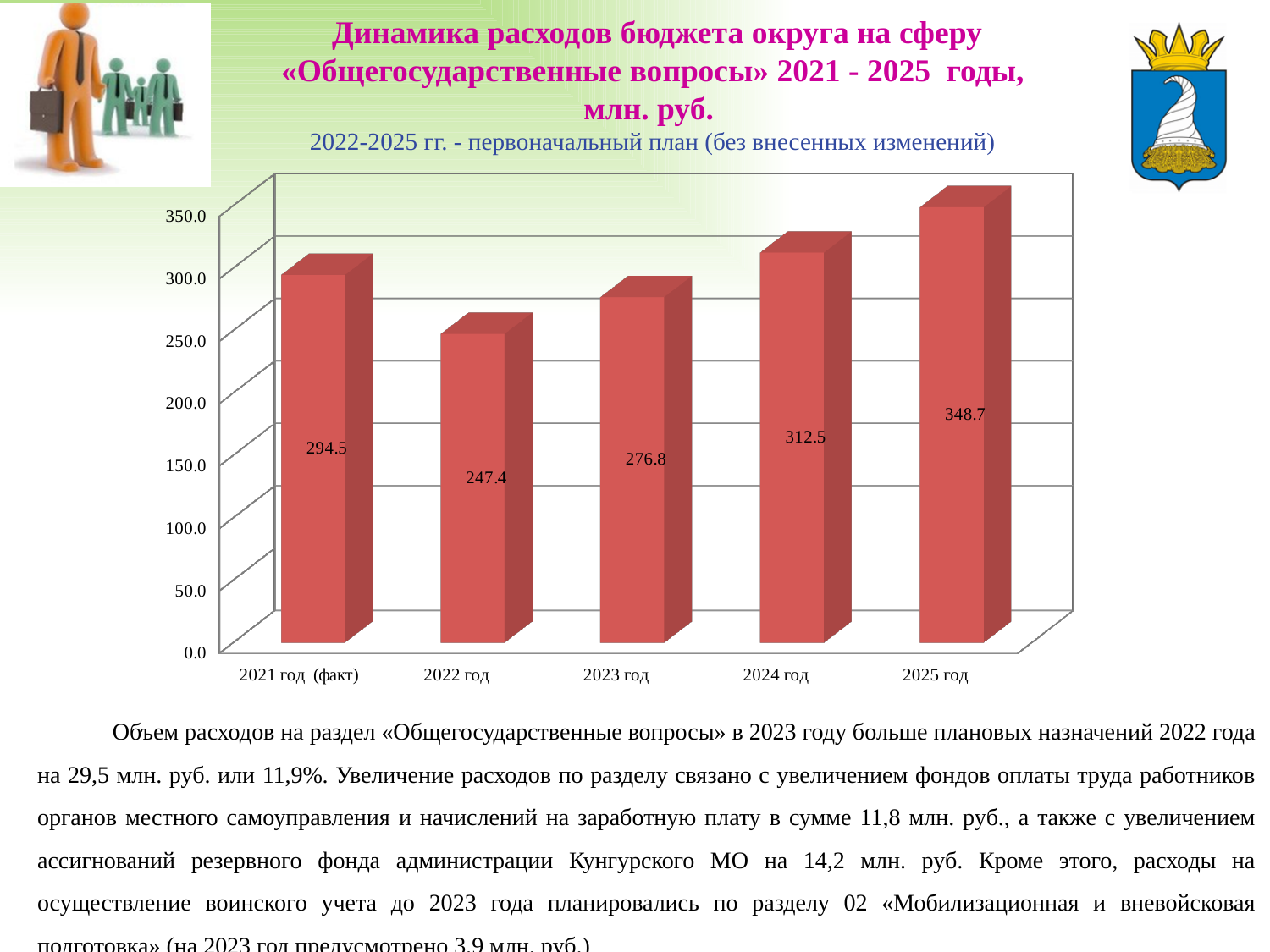
What is the value for 2022 год? 247.4 Do the values rise or fall from 2022 год to 2025 год? rise How many years are shown on the x axis? 5 Which is larger, the value for 2021 год (факт) or the value for 2023 год? 2021 год (факт) What is the difference between the values for 2025 год and 2024 год? 36.2 Which year has the highest value? 2025 год What is the difference between the values for 2023 год and 2022 год? 29.4 Is the value for 2024 год greater or less than 300.0? greater What is the value for 2025 год? 348.7 What is the value for 2023 год? 276.8 What is the value for 2021 год (факт)? 294.5 Which year has the lowest value? 2022 год